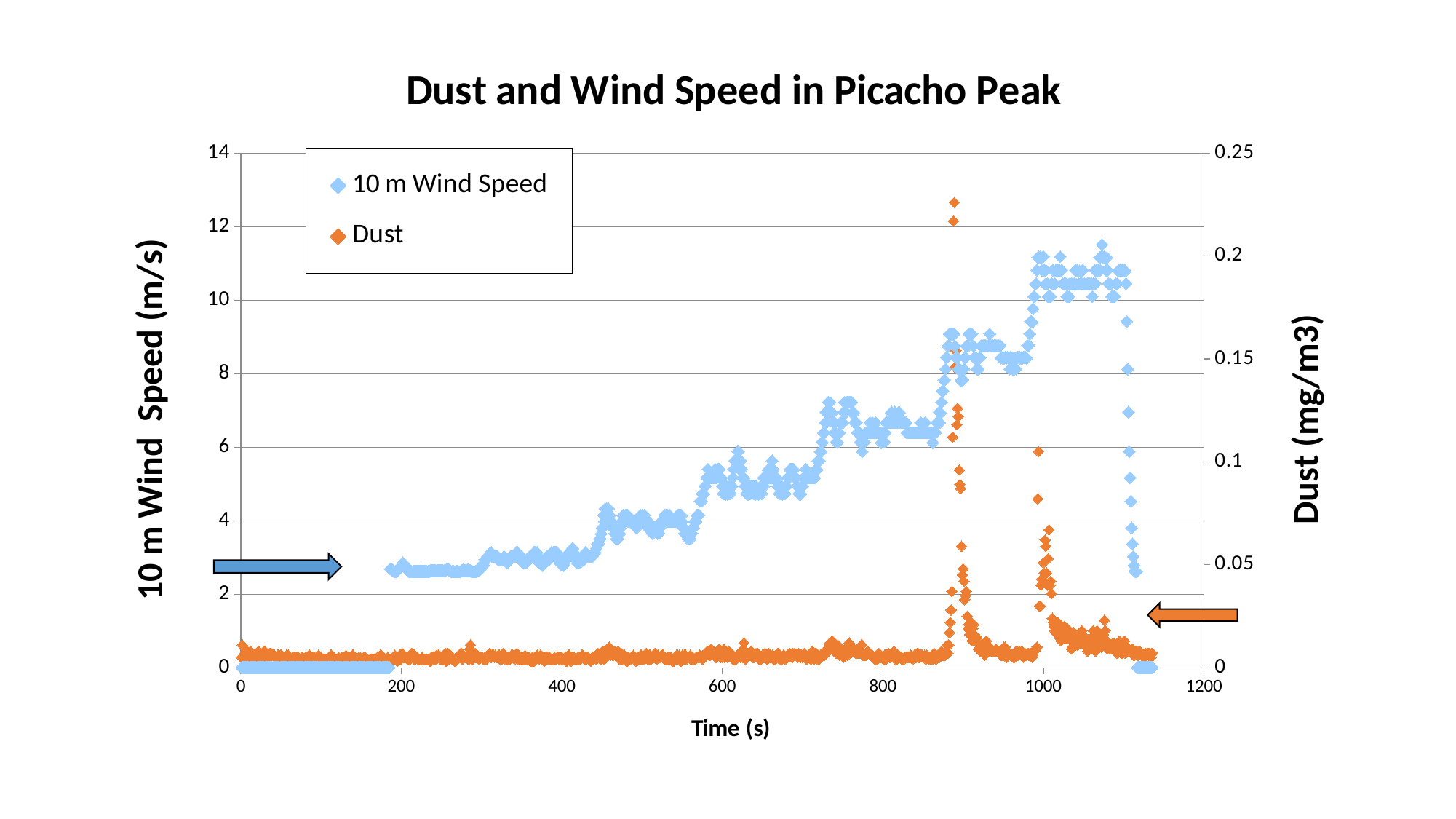
Which series has the higher value at around 1000 s when read on its own axis scale, 10 m Wind Speed (m/s) or Dust (mg/m3)? 10 m Wind Speed Is the 10 m Wind Speed value at around 500 s greater or less than 6 m/s? less What is the label of the x axis? Time (s) Is the 10 m Wind Speed value at around 1050 s greater or less than 10 m/s? greater Is the Dust value at around 600 s greater or less than 0.05 mg/m3? less What is the maximum value shown on the left vertical axis? 14 Does the 10 m Wind Speed series generally rise or fall as time increases from 200 s to 1100 s? rise What is the title of the chart? Dust and Wind Speed in Picacho Peak What kind of chart is shown on the slide? scatter chart How many series does the legend list? 2